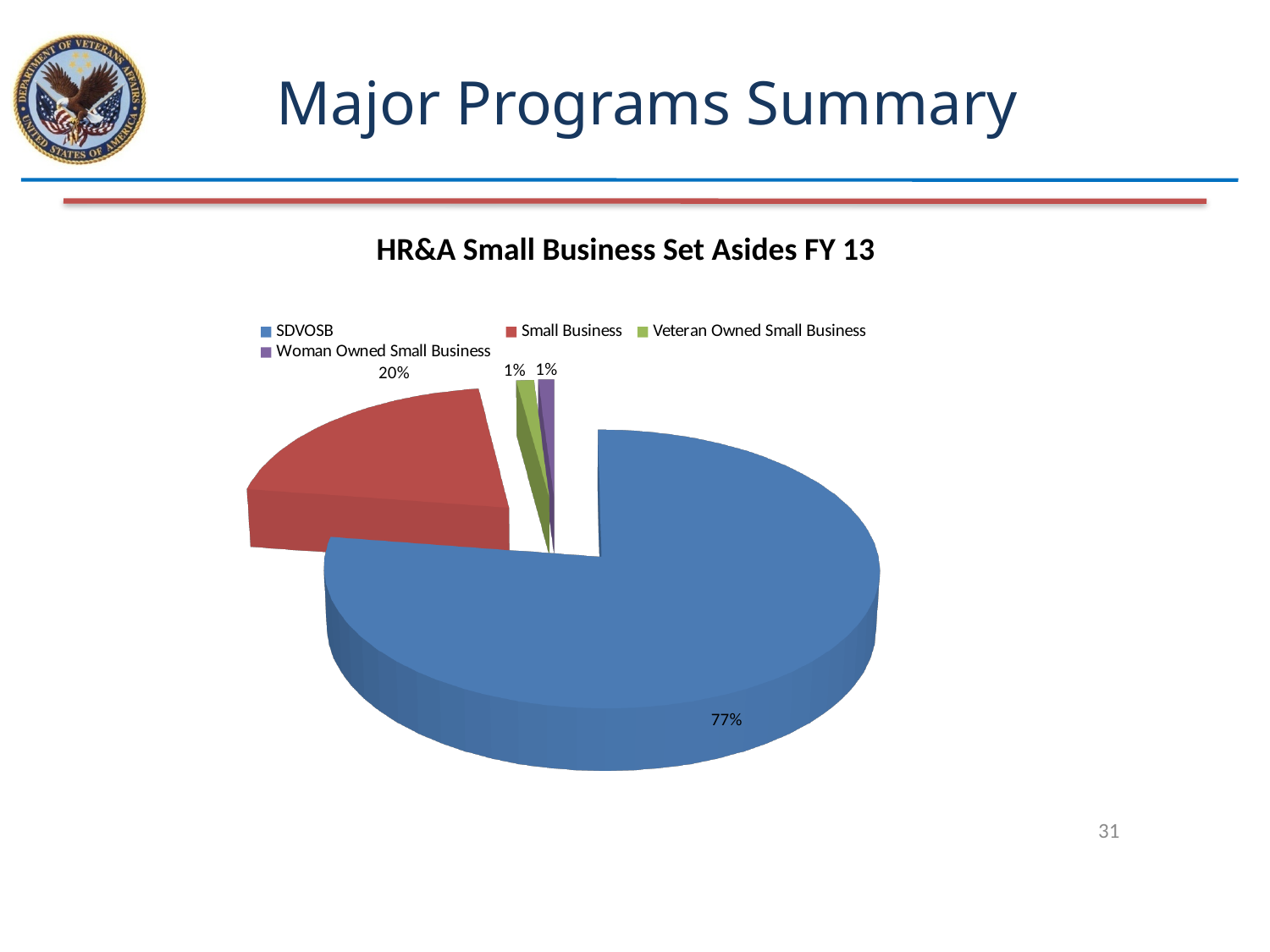
What kind of chart is shown on the slide? pie chart What percentage of the pie does SDVOSB account for? 77% Which category has the largest slice of the pie? SDVOSB What percentage of the pie does Veteran Owned Small Business account for? 1% What percentage of the pie does Small Business account for? 20% What share of the pie is taken by Small Business? 20% How many percentage points larger is the SDVOSB slice than the Small Business slice? 57 What is the title of the chart? HR&A Small Business Set Asides FY 13 What percentage of the pie does Woman Owned Small Business account for? 1% What colour is the Small Business slice? red Which is larger, the SDVOSB slice or the Small Business slice? SDVOSB How many categories does the pie chart show? 4